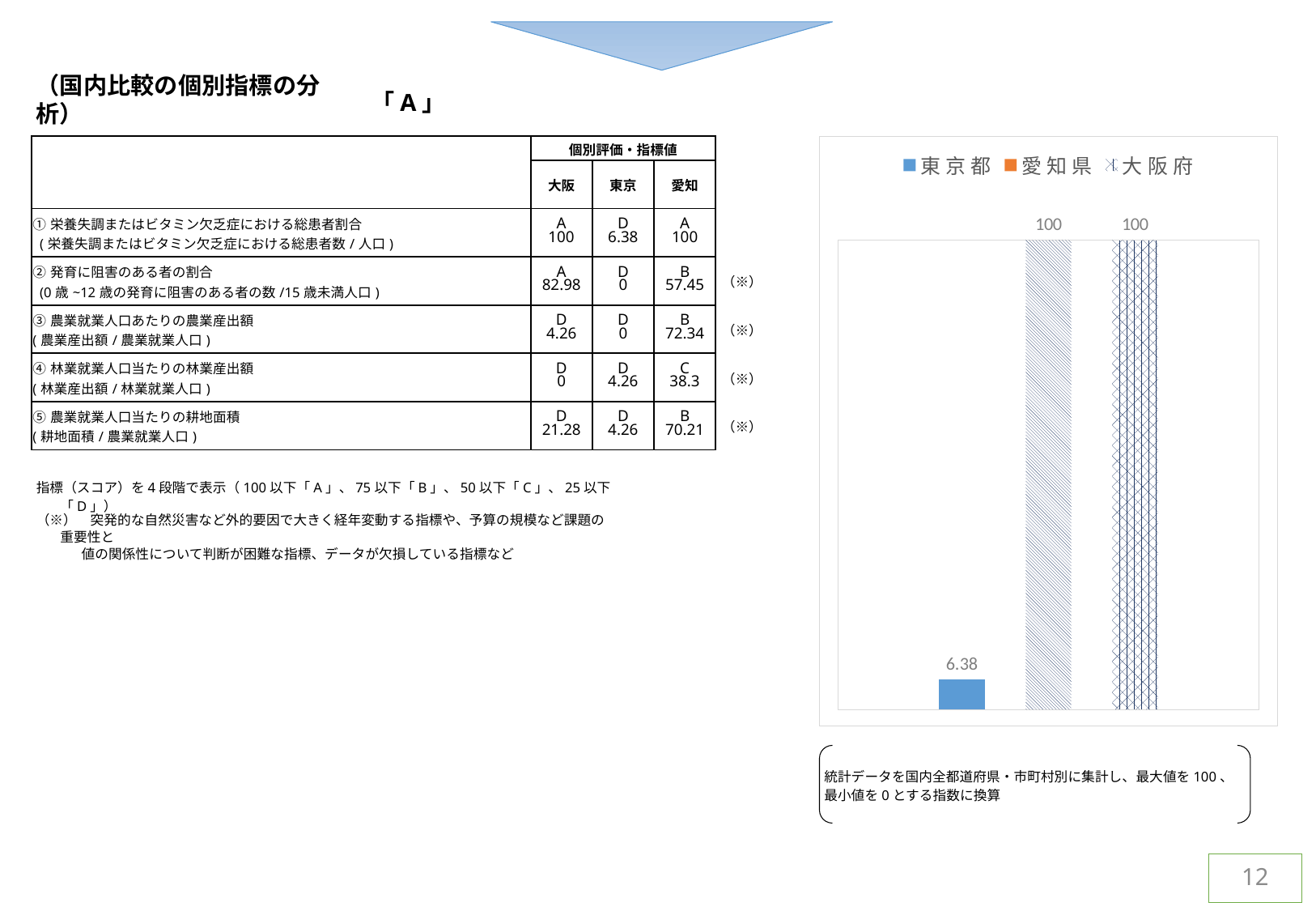
How many bars are plotted in the chart? 3 What value is shown for 大阪府 in the bar chart? 100 What are the legend entries of the bar chart, in order? 東京都, 愛知県, 大阪府 What value is shown for 愛知県 in the bar chart? 100 Which series has the lowest value in the bar chart? 東京都 How many series does the legend of the bar chart list? 3 What is the difference between the values for 愛知県 and 東京都 in the bar chart? 93.62 What colour is the bar for 東京都 in the chart? blue What value is shown for 東京都 in the bar chart? 6.38 What kind of chart is shown on the right of the slide? bar chart Which is larger in the bar chart, the value for 東京都 or the value for 大阪府? 大阪府